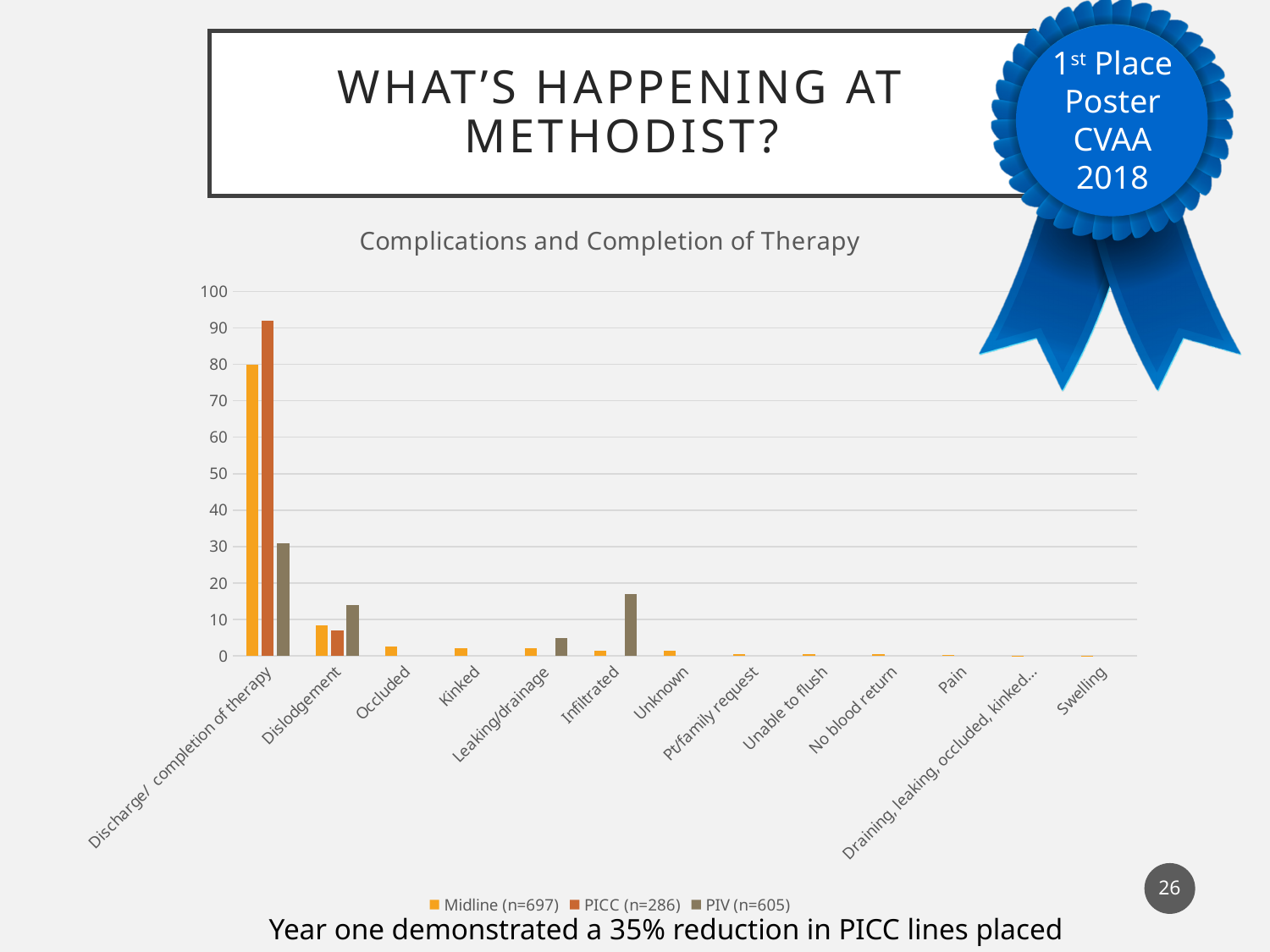
For Dislodgement, which is larger: the Midline (n=697) value or the PIV (n=605) value? PIV (n=605) How many series does the legend list? 3 Is the PIV (n=605) value for Discharge/ completion of therapy greater or less than 40? less Which category has the highest PIV (n=605) value? Discharge/ completion of therapy Is the PIV (n=605) value for Infiltrated greater or less than 10? greater For Discharge/ completion of therapy, which is larger: the Midline (n=697) value or the PICC (n=286) value? PICC (n=286) Is the PICC (n=286) value for Discharge/ completion of therapy greater or less than 80? greater Which series has the highest value for Discharge/ completion of therapy? PICC (n=286) Which series are listed in the legend? Midline (n=697), PICC (n=286), PIV (n=605) What is the title of the chart? Complications and Completion of Therapy What kind of chart is shown on the slide? Bar chart How many categories are shown on the x axis? 13